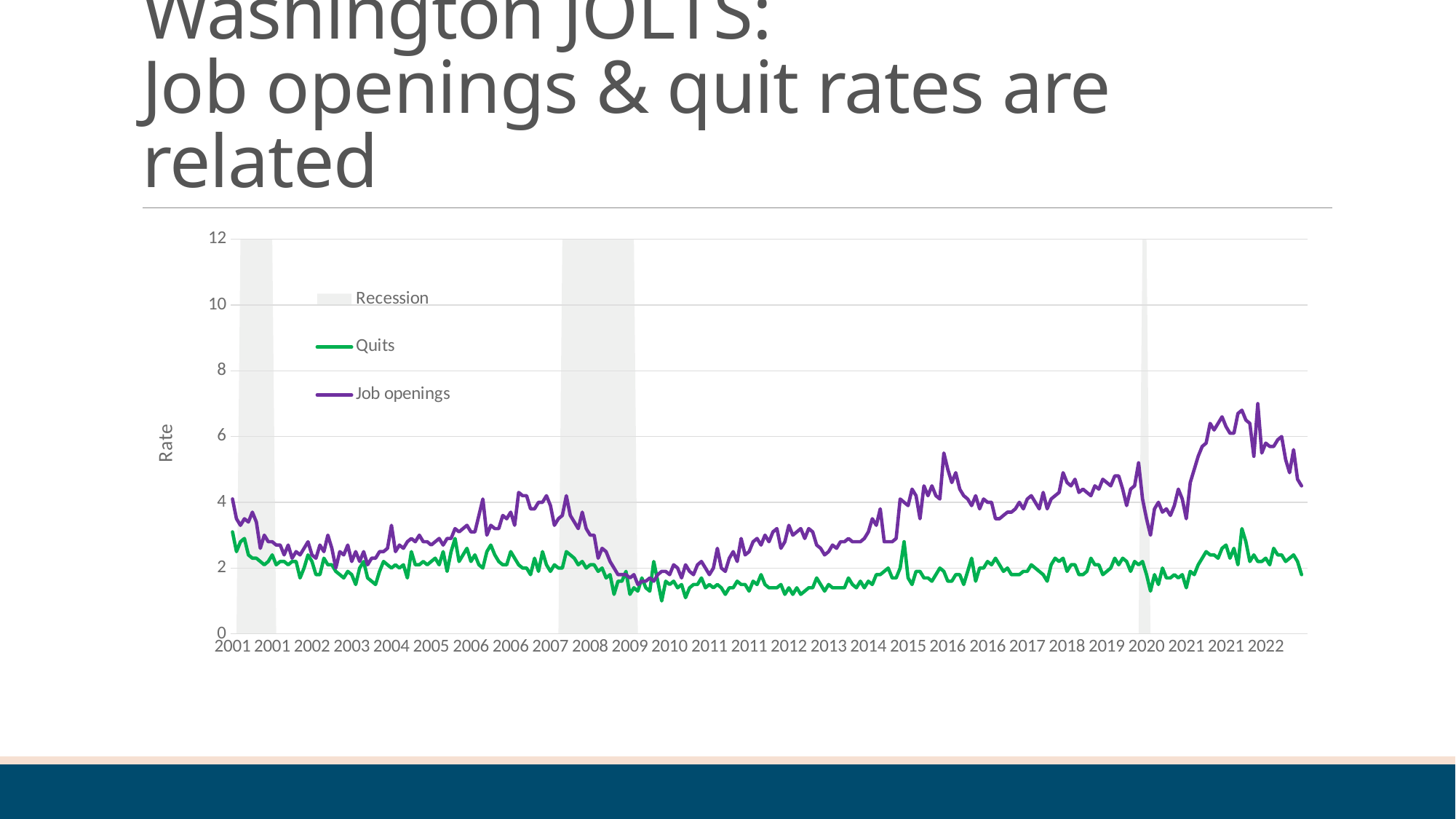
In 2021, which series has the larger value, Quits or Job openings? Job openings Is the peak value of the Job openings line in 2021 greater or less than 6? greater What is the label on the vertical axis of the chart? Rate Is the value of the Job openings line in 2009 greater or less than 4? less How many data series are plotted as lines on the chart? 2 Which series reaches the highest value on the chart, Quits or Job openings? Job openings How many entries does the chart legend list? 3 Is the peak value of the Job openings line in 2016 greater or less than 4? greater Does the Job openings line generally rise or fall between 2009 and 2016? rise What does the grey shading on the chart represent, according to the legend? Recession What kind of chart is shown on the slide? line chart